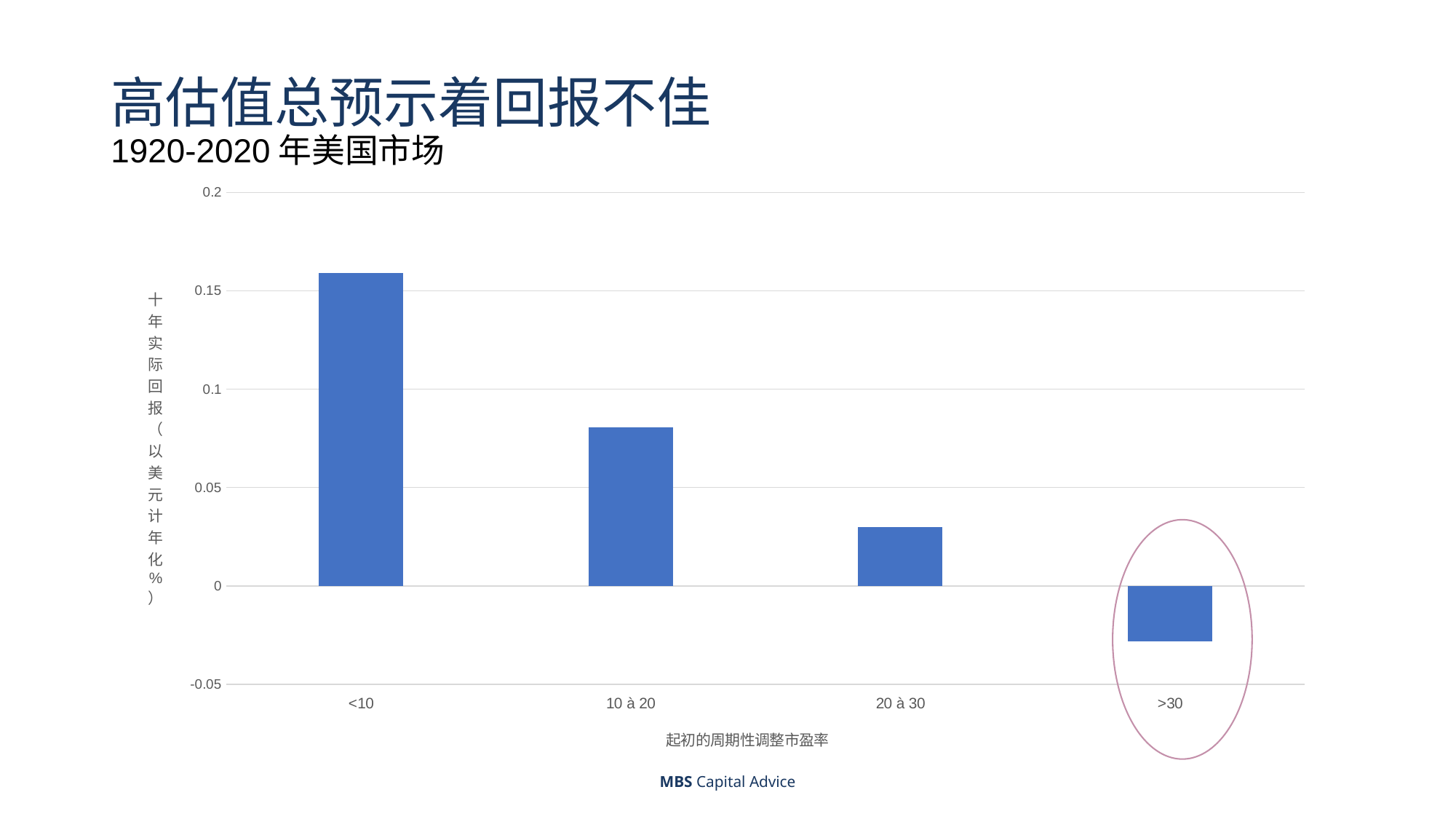
Is the value for <10 greater or less than 0.15? greater What kind of chart is shown on the slide? bar chart Which category on the chart is circled? >30 Which category has the highest ten-year real return? <10 Is the value for 20 à 30 greater or less than 0.05? less Which category has the lowest ten-year real return? >30 Is the value for 10 à 20 greater or less than 0.1? less What is the x-axis label of the chart? 起初的周期性调整市盈率 Which is larger, the value for 10 à 20 or the value for 20 à 30? 10 à 20 Do the values rise or fall as you move from <10 to >30 along the x axis? fall How many categories are plotted on the x axis? 4